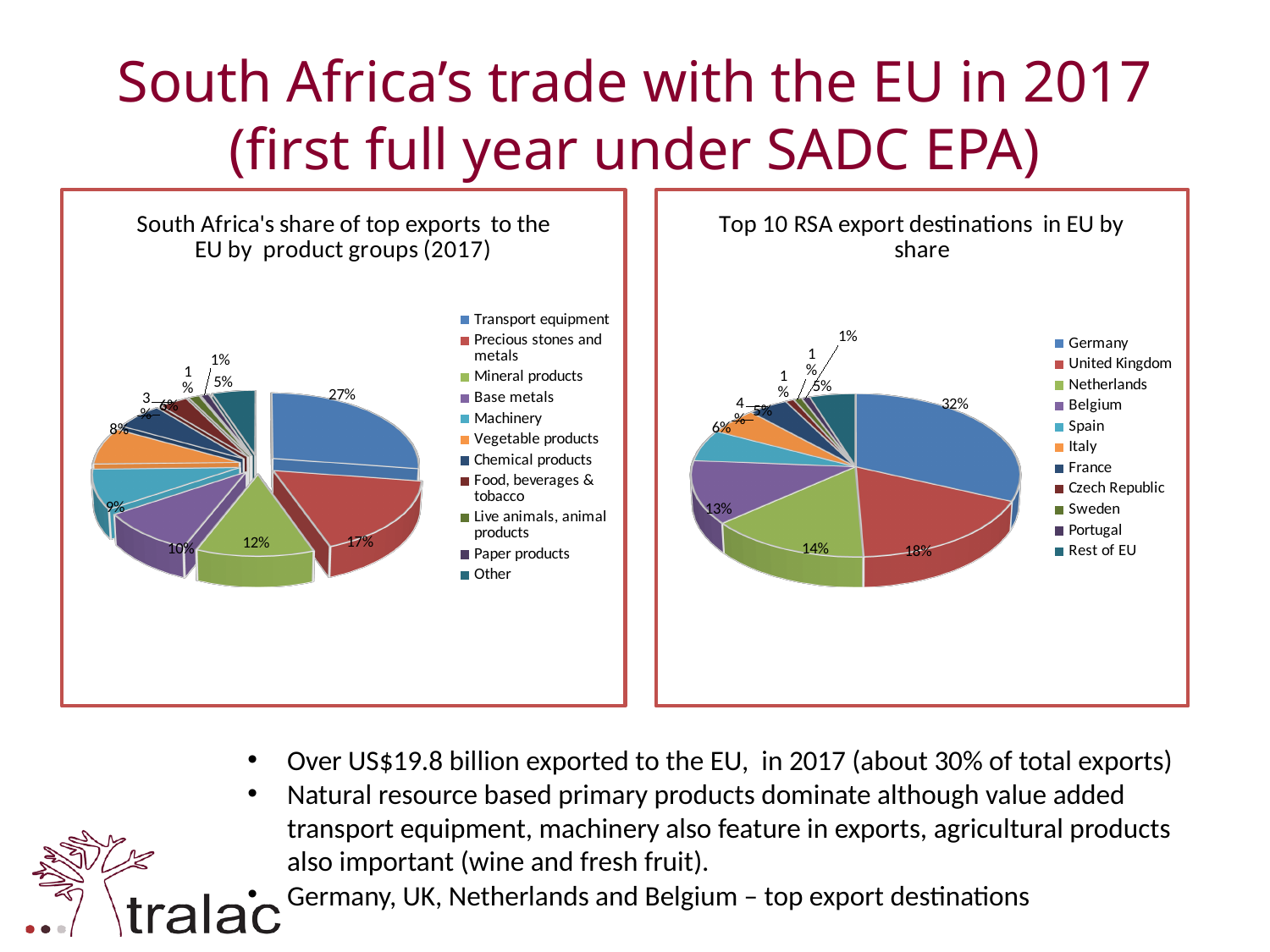
In the chart 'Top 10 RSA export destinations in EU by share', what share does Germany have? 32% In the chart 'South Africa's share of top exports to the EU by product groups (2017)', which is larger: Base metals or Machinery? Base metals How many product groups does the legend of the left chart list? 11 In the chart 'South Africa's share of top exports to the EU by product groups (2017)', what is the difference between the shares of Transport equipment and Precious stones and metals? 10 percentage points In the chart 'Top 10 RSA export destinations in EU by share', what share does the United Kingdom have? 18% In the chart 'South Africa's share of top exports to the EU by product groups (2017)', what share does Transport equipment have? 27% In the chart 'Top 10 RSA export destinations in EU by share', which destination has the largest share? Germany In the chart 'Top 10 RSA export destinations in EU by share', what is the difference between the shares of the Netherlands and Belgium? 1 percentage point In the chart 'South Africa's share of top exports to the EU by product groups (2017)', what share do Precious stones and metals have? 17% In the chart 'South Africa's share of top exports to the EU by product groups (2017)', which product group has the largest share? Transport equipment What kind of chart is 'Top 10 RSA export destinations in EU by share'? Pie chart In the chart 'South Africa's share of top exports to the EU by product groups (2017)', what share do Mineral products have? 12%